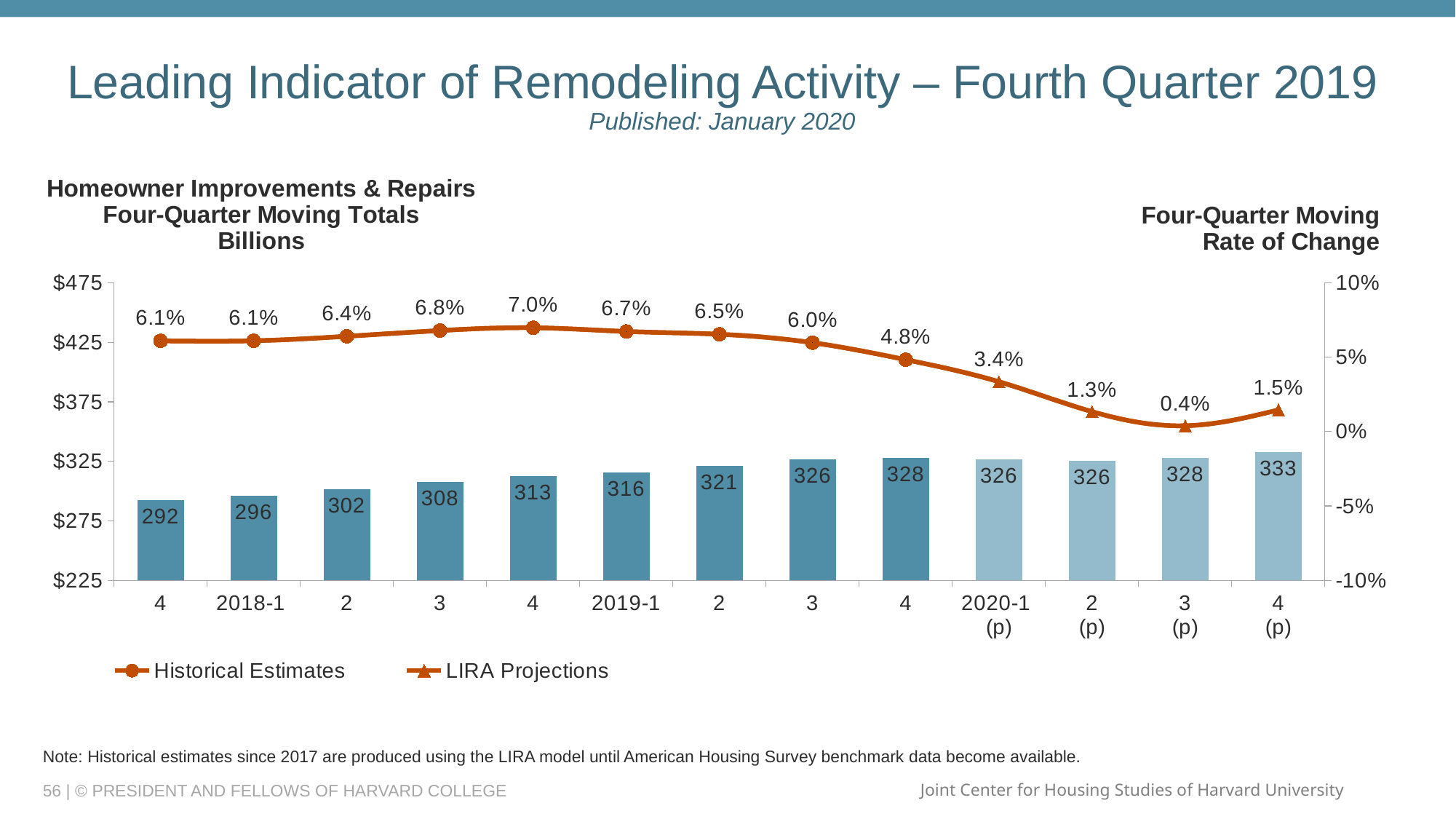
What is the four-quarter moving total (in billions) for 2019-1? 316 Which quarter has the highest four-quarter moving total? 4 (p) (2020) How many series does the legend list? 2 How many bars are plotted in the chart? 13 What is the difference between the four-quarter moving total for 2020-4 (p) and the total for 2018-1? 37 Does the four-quarter moving rate of change rise or fall from 2018-4 to 2020-3 (p)? fall What is the four-quarter moving total for the third quarter of 2019? 326 Which quarter has the highest four-quarter moving rate of change? 4 (2018) Which quarter has the lowest four-quarter moving rate of change? 3 (p) (2020) What is the difference in the rate of change between 2019-4 and 2020-1 (p)? 1.4% What is the four-quarter moving rate of change for the fourth quarter of 2020 (p)? 1.5% Which is larger, the four-quarter moving total for 2019-2 or for 2018-4? 2019-2